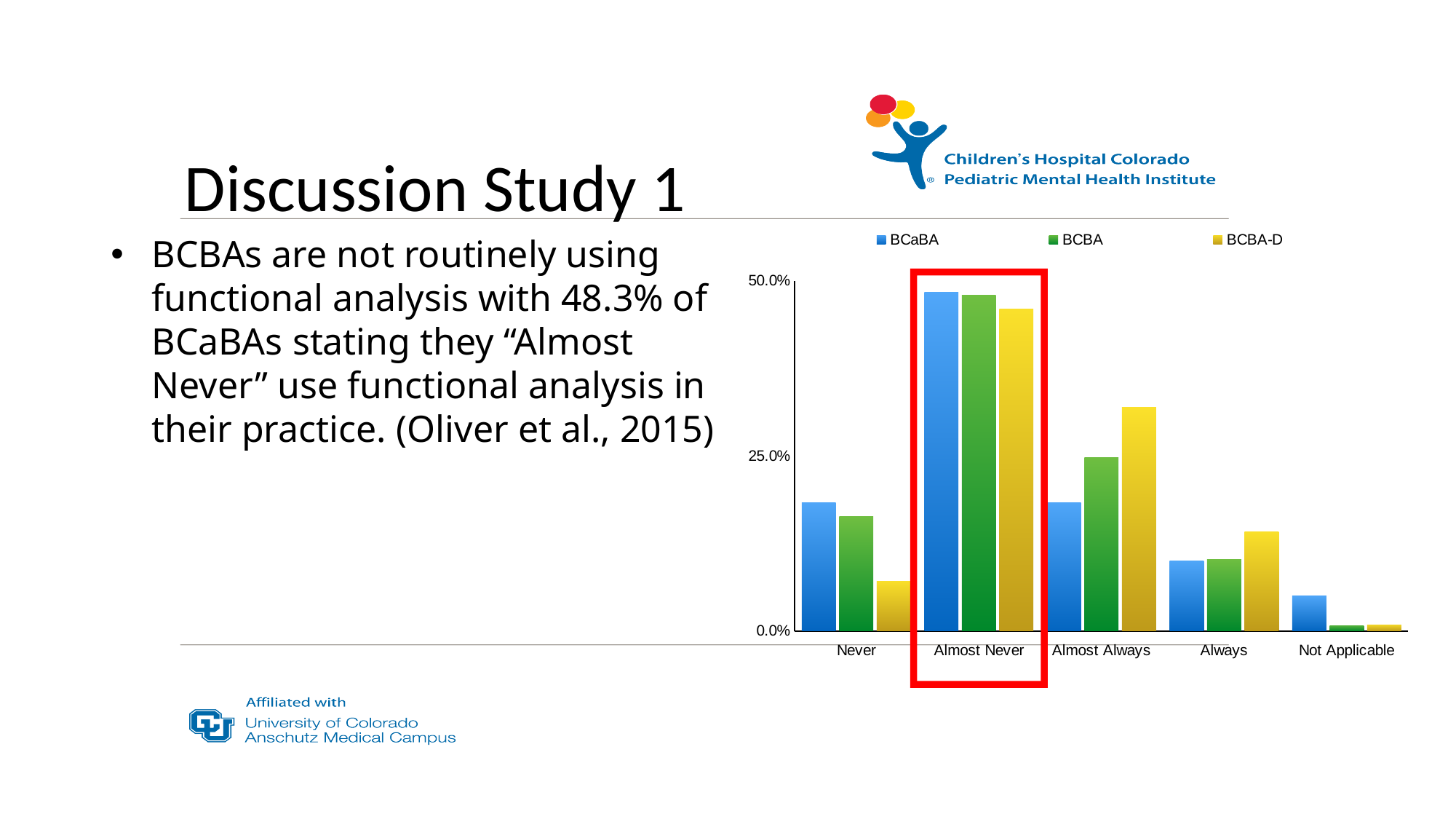
Is the BCBA value for Almost Never greater or less than 50.0%? less For the BCaBA series, which category has the highest bar? Almost Never Which category on the chart is outlined with a red box? Almost Never Is the BCBA-D value for Almost Always greater or less than 25.0%? greater In the Almost Always category, which is larger: the BCBA bar or the BCBA-D bar? BCBA-D How many categories are shown on the x axis of the chart? 5 For the BCBA series, which category has the lowest bar? Not Applicable Is the BCaBA value for Never greater or less than 25.0%? less What kind of chart is shown on the slide? bar chart How many series does the chart legend list? 3 In the Never category, which is larger: the BCaBA bar or the BCBA-D bar? BCaBA For the BCBA-D series, which category has the highest bar? Almost Never